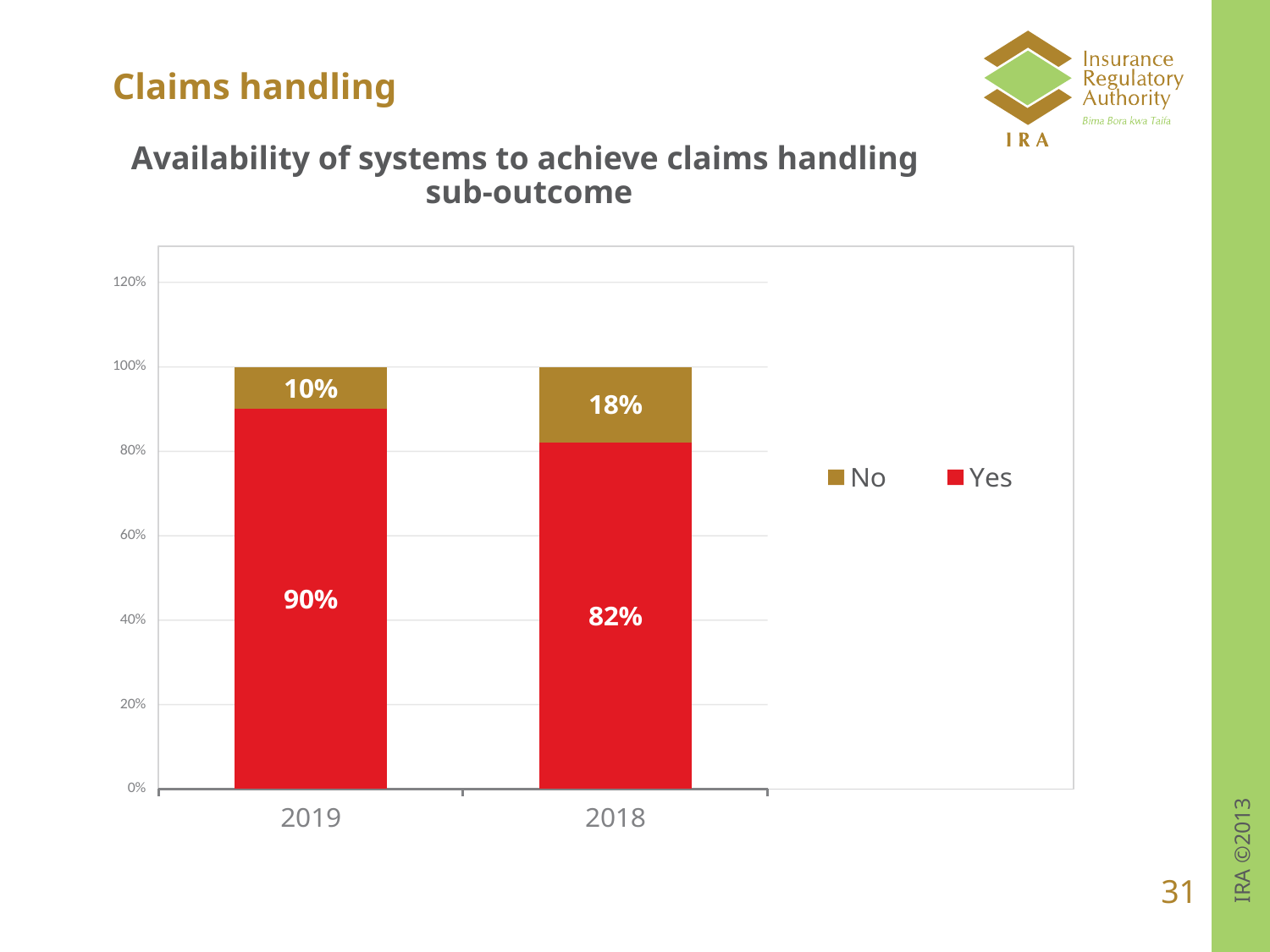
What is the value for No in 2019? 10% Which year has the higher value for Yes? 2019 Which year has the lower value for No? 2019 How many years are shown on the x axis? 2 Is the No value for 2018 larger or smaller than the No value for 2019? larger What is the difference between the Yes values for 2019 and 2018? 8% What is the value for Yes in 2018? 82% How many series does the legend list? 2 What kind of chart is shown on the slide? Stacked bar chart What is the value for Yes in 2019? 90% What is the value for No in 2018? 18% What is the total of the stacked bar for 2019? 100%